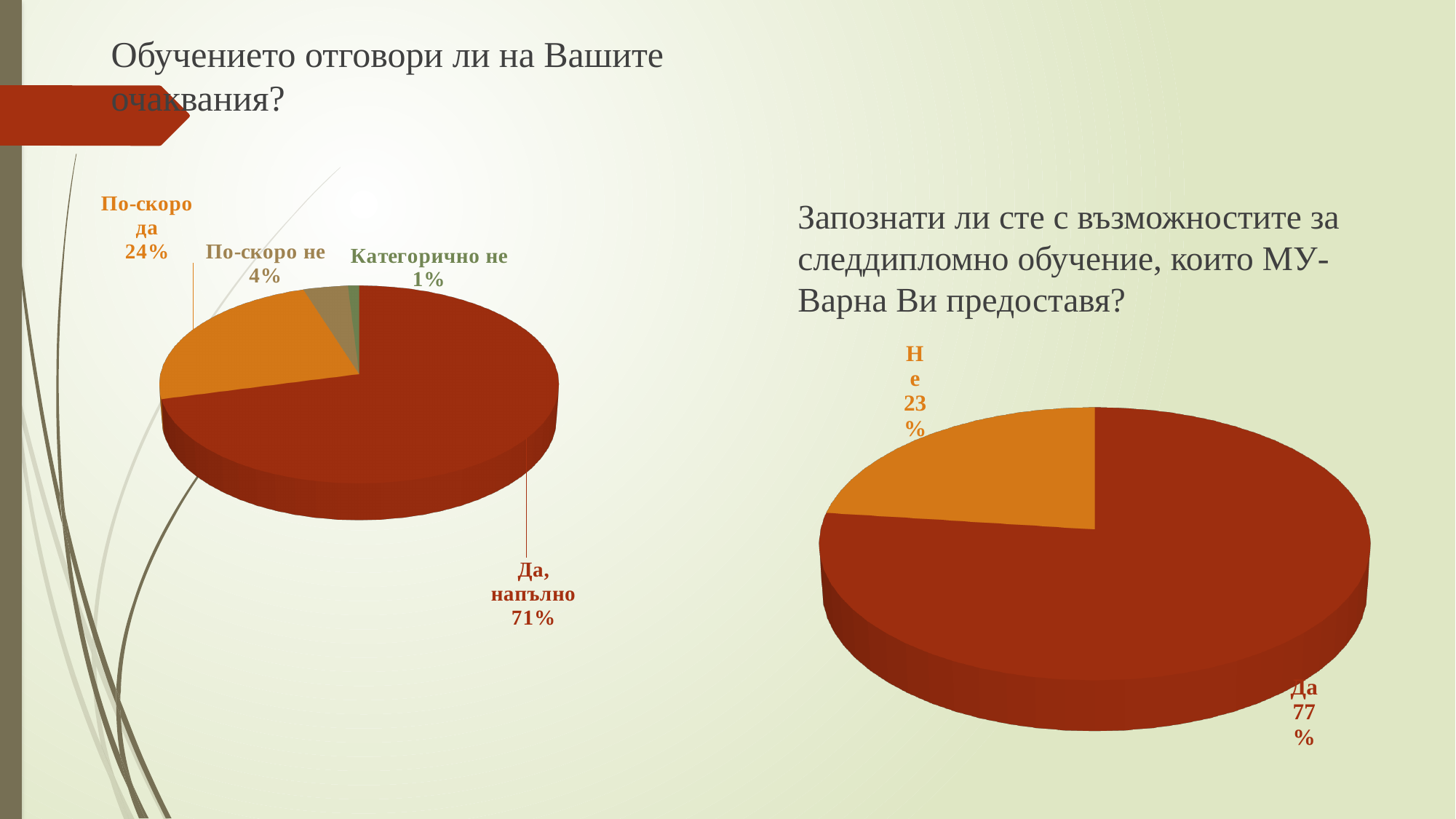
In the right pie chart, which slice is larger, "Да" or "Не"? Да In the left pie chart, which category has the largest slice? Да, напълно In the right pie chart, what percentage of respondents answered "Да"? 77% In the left pie chart, what is the difference in percentage points between "По-скоро да" and "По-скоро не"? 20 In the left pie chart, what share of respondents answered "Да, напълно"? 71% In the left pie chart, what percentage is shown for "По-скоро да"? 24% In the right pie chart, what is the difference in percentage points between "Да" and "Не"? 54 In the left pie chart, which category has the smallest slice? Категорично не What type of chart is used on the right side of the slide? Pie chart In the left pie chart, what percentage is shown for "Категорично не"? 1% In the left pie chart, how many slices does the pie have? 4 In the right pie chart, what percentage of respondents answered "Не"? 23%